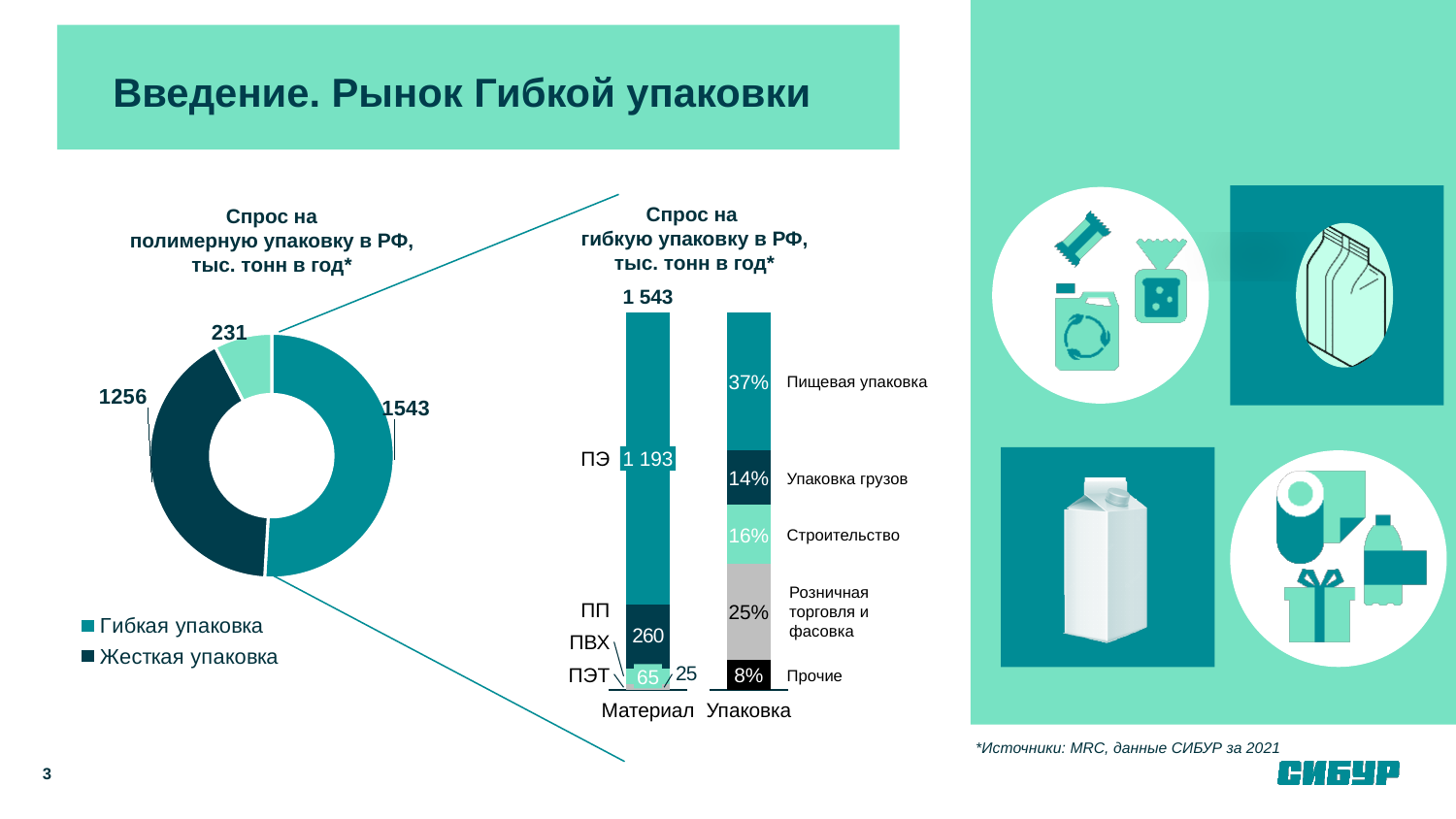
How many entries does the legend of the doughnut chart 'Спрос на полимерную упаковку в РФ' list? 2 In the stacked bar chart 'Спрос на гибкую упаковку в РФ', which is larger in the Упаковка bar: Упаковка грузов or Строительство? Строительство In the stacked bar chart 'Спрос на гибкую упаковку в РФ', what is the value for ПЭ in the Материал bar? 1 193 In the stacked bar chart 'Спрос на гибкую упаковку в РФ', how many segments make up the Упаковка bar? 5 In the doughnut chart 'Спрос на полимерную упаковку в РФ', what is the value of the smallest slice? 231 In the stacked bar chart 'Спрос на гибкую упаковку в РФ', what share does Пищевая упаковка have in the Упаковка bar? 37% In the stacked bar chart 'Спрос на гибкую упаковку в РФ', what is the value for ПП in the Материал bar? 260 In the stacked bar chart 'Спрос на гибкую упаковку в РФ', which segment of the Упаковка bar is the smallest? Прочие In the doughnut chart 'Спрос на полимерную упаковку в РФ', what is the difference between the 1543 slice and the 1256 slice? 287 In the stacked bar chart 'Спрос на гибкую упаковку в РФ', what is the total of the Материал bar? 1 543 In the doughnut chart 'Спрос на полимерную упаковку в РФ', what is the value of the largest slice? 1543 What type of chart is 'Спрос на полимерную упаковку в РФ'? Doughnut chart